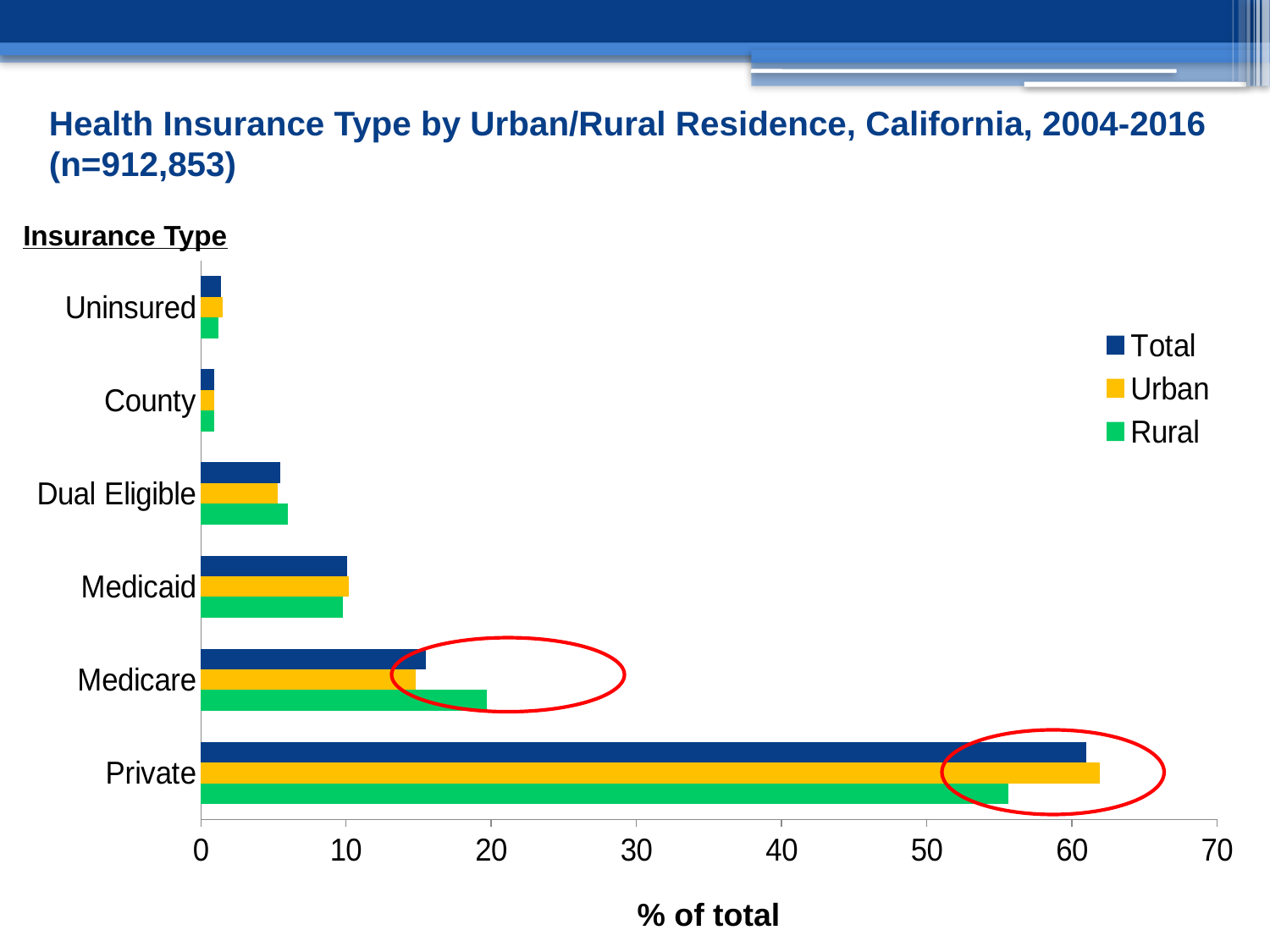
For Medicare, which is larger: the Urban value or the Rural value? Rural For Private insurance, which is larger: the Urban value or the Rural value? Urban Is the Urban value for Private greater or less than 60? greater Is the Rural value for Private greater or less than 60? less Is the Rural value for Dual Eligible greater or less than 10? less How many series does the legend list? 3 What is the label on the horizontal axis of the chart? % of total Which insurance type has the highest values across all series? Private Which insurance type has the lowest values across all series? County What kind of chart is shown on the slide? bar chart How many insurance type categories are shown on the chart? 6